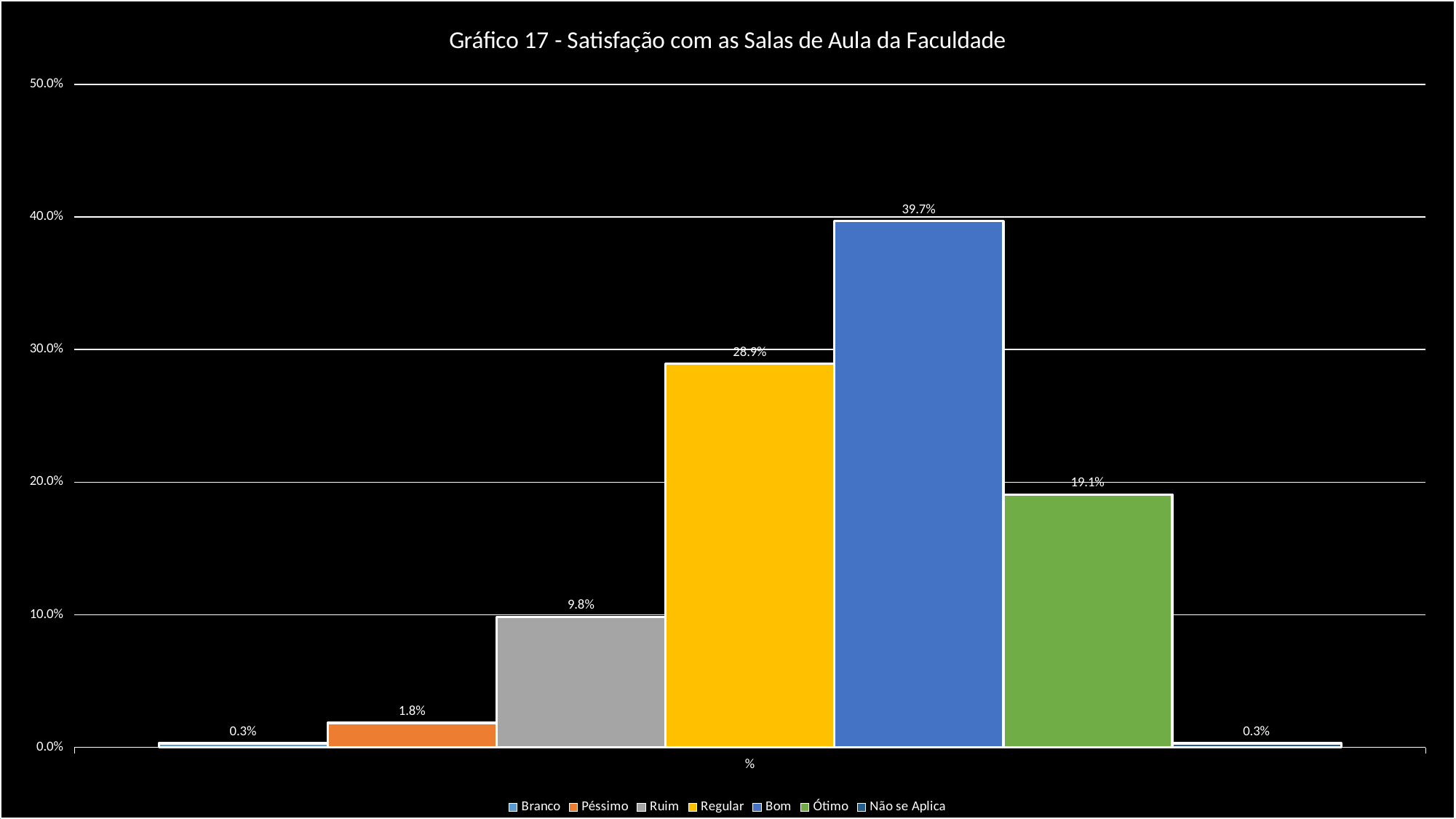
Which series has the highest value? Bom How many series does the legend list? 7 What is the value for Péssimo? 1.8% What is the title of the chart? Gráfico 17 - Satisfação com as Salas de Aula da Faculdade What is the difference between the values for Ótimo and Ruim? 9.3% What is the difference between the values for Bom and Regular? 10.8% What kind of chart is shown? Bar chart What is the value for Ótimo? 19.1% Which is larger, the value for Regular or the value for Ótimo? Regular What is the value for Ruim? 9.8% What is the value for Regular? 28.9% What is the value for Bom? 39.7%